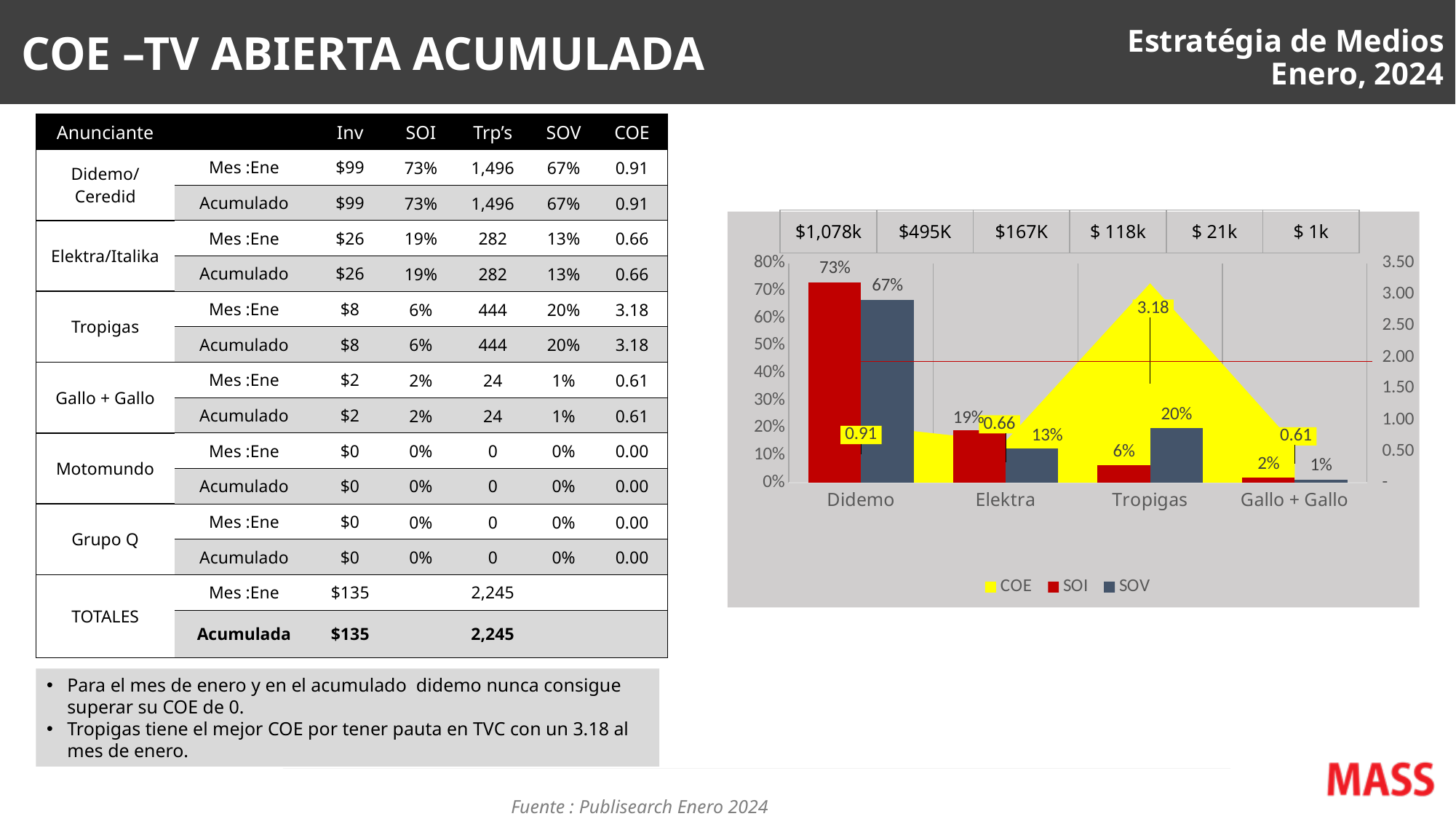
Which is larger for Tropigas, the SOI value or the SOV value? SOV How many series does the chart legend list? 3 What is the SOV value for Tropigas in the chart? 20% What is the SOV value for Gallo + Gallo in the chart? 1% What is the COE value for Elektra in the chart? 0.66 How many categories are shown on the x axis of the chart? 4 What is the SOI value for Didemo in the chart? 73% Which category has the highest COE value in the chart? Tropigas What is the difference between the SOI and SOV values for Didemo? 6% Which category has the lowest SOI value in the chart? Gallo + Gallo Is the SOI value for Elektra greater or less than 10%? greater Which series in the chart is shown in yellow? COE